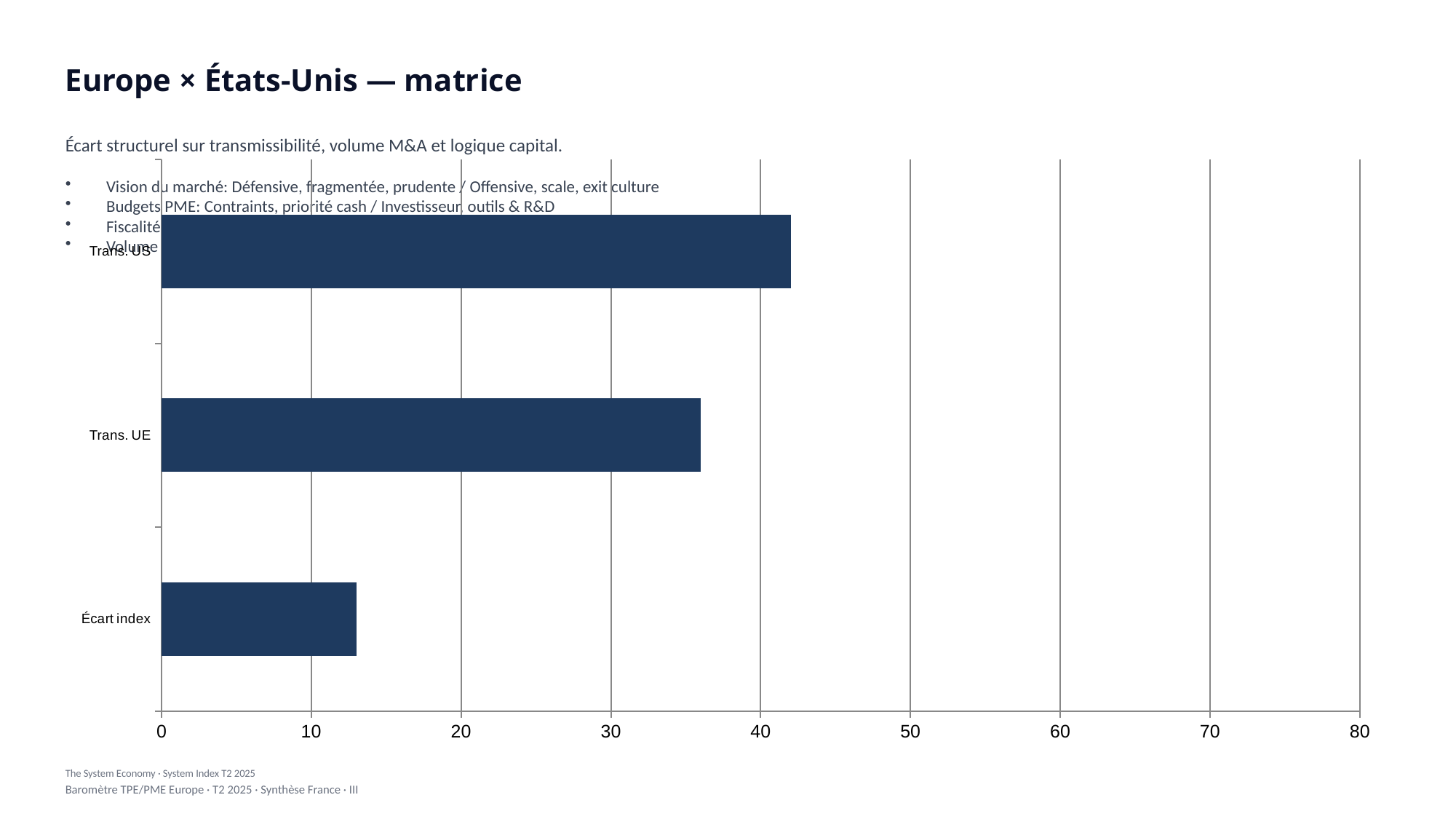
Is the value for Trans. US greater or less than 40? greater How many categories does the bar chart show? 3 Which category has the lowest value in the bar chart? Écart index Which is larger, the value for Trans. US or the value for Trans. UE? Trans. US What kind of chart is shown on the slide? bar chart Is the value for Trans. UE greater or less than 40? less Is the value for Trans. UE greater or less than 30? greater Which category has the highest value in the bar chart? Trans. US What is the maximum value shown on the horizontal axis of the bar chart? 80 Which is larger, the value for Trans. UE or the value for Écart index? Trans. UE